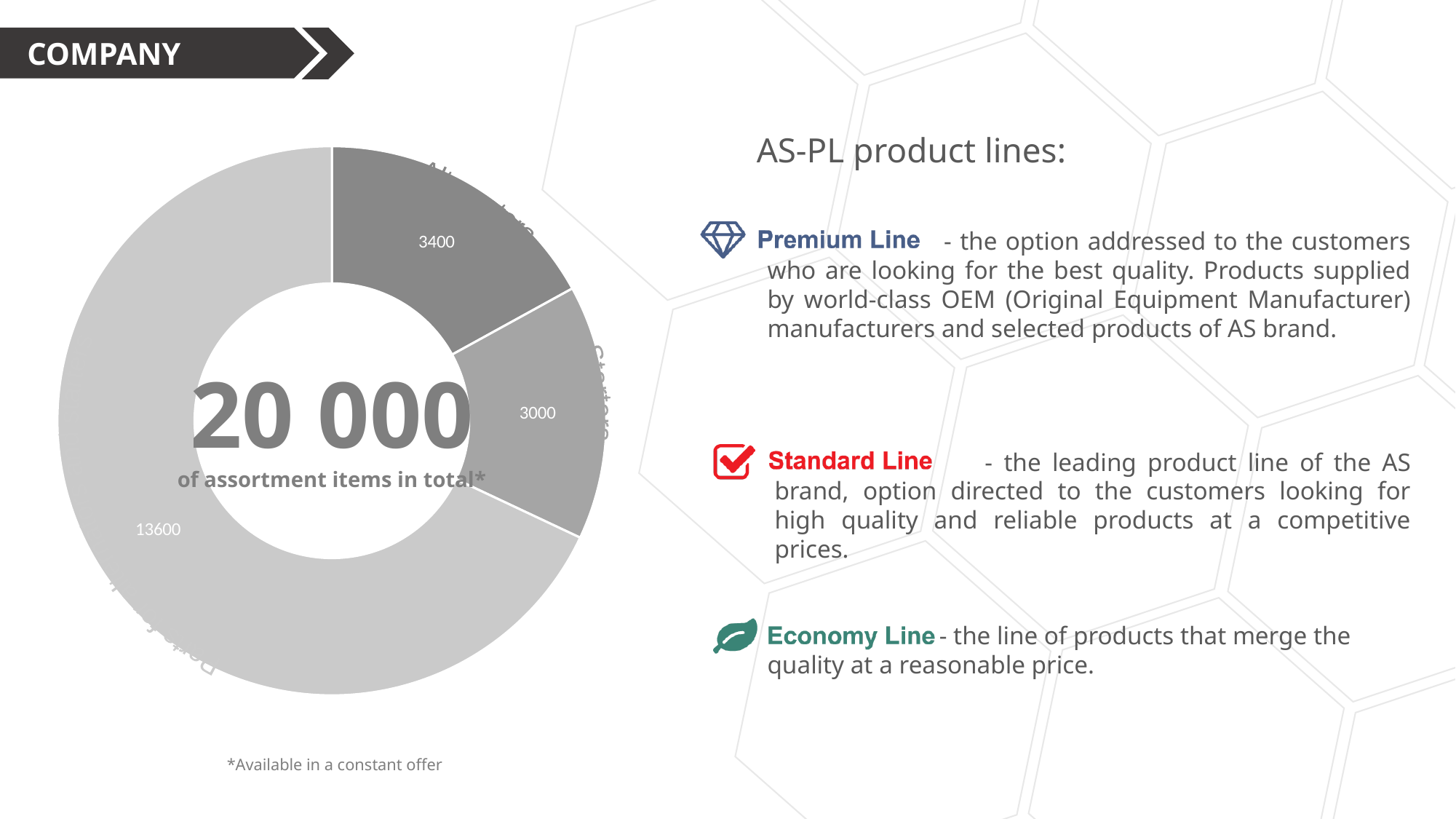
What is the value shown on the lightest gray slice of the doughnut chart? 13600 What is the total of all slices in the doughnut chart, as printed in its centre? 20 000 What is the value of the largest slice in the doughnut chart? 13600 What share of the total does the slice labelled 13600 represent? 68% What is the value shown on the darkest gray slice of the doughnut chart? 3400 What is the difference between the largest slice (13600) and the slice labelled 3400? 10200 What is the value of the smallest slice in the doughnut chart? 3000 How many slices does the doughnut chart have? 3 What text is printed in the centre of the doughnut chart below the large number? of assortment items in total* What is the difference between the slice labelled 3400 and the slice labelled 3000? 400 What kind of chart is shown on the slide? doughnut chart Which is larger: the darkest gray slice or the medium gray slice? the darkest gray slice (3400)